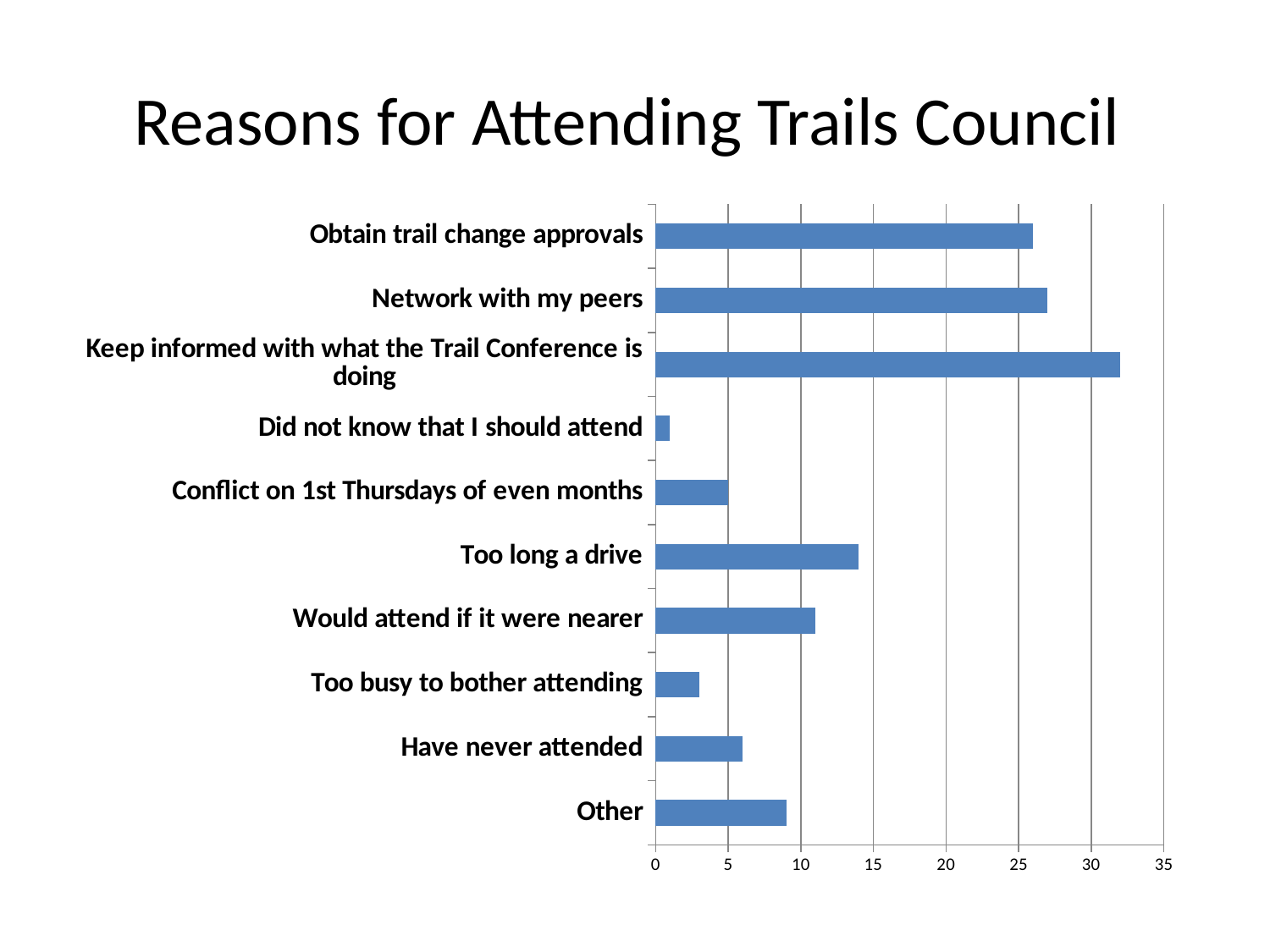
Is the value for "Network with my peers" greater or less than 25? greater What is the title of the chart? Reasons for Attending Trails Council What kind of chart is shown on the slide? bar chart Is the value for "Too long a drive" greater or less than 10? greater Which is larger: the value for "Other" or the value for "Have never attended"? Other Which reason has the lowest value? Did not know that I should attend Is the value for "Other" greater or less than 10? less Which reason has the highest value? Keep informed with what the Trail Conference is doing How many categories (reasons) are plotted in the chart? 10 Which is larger: the value for "Too long a drive" or the value for "Would attend if it were nearer"? Too long a drive